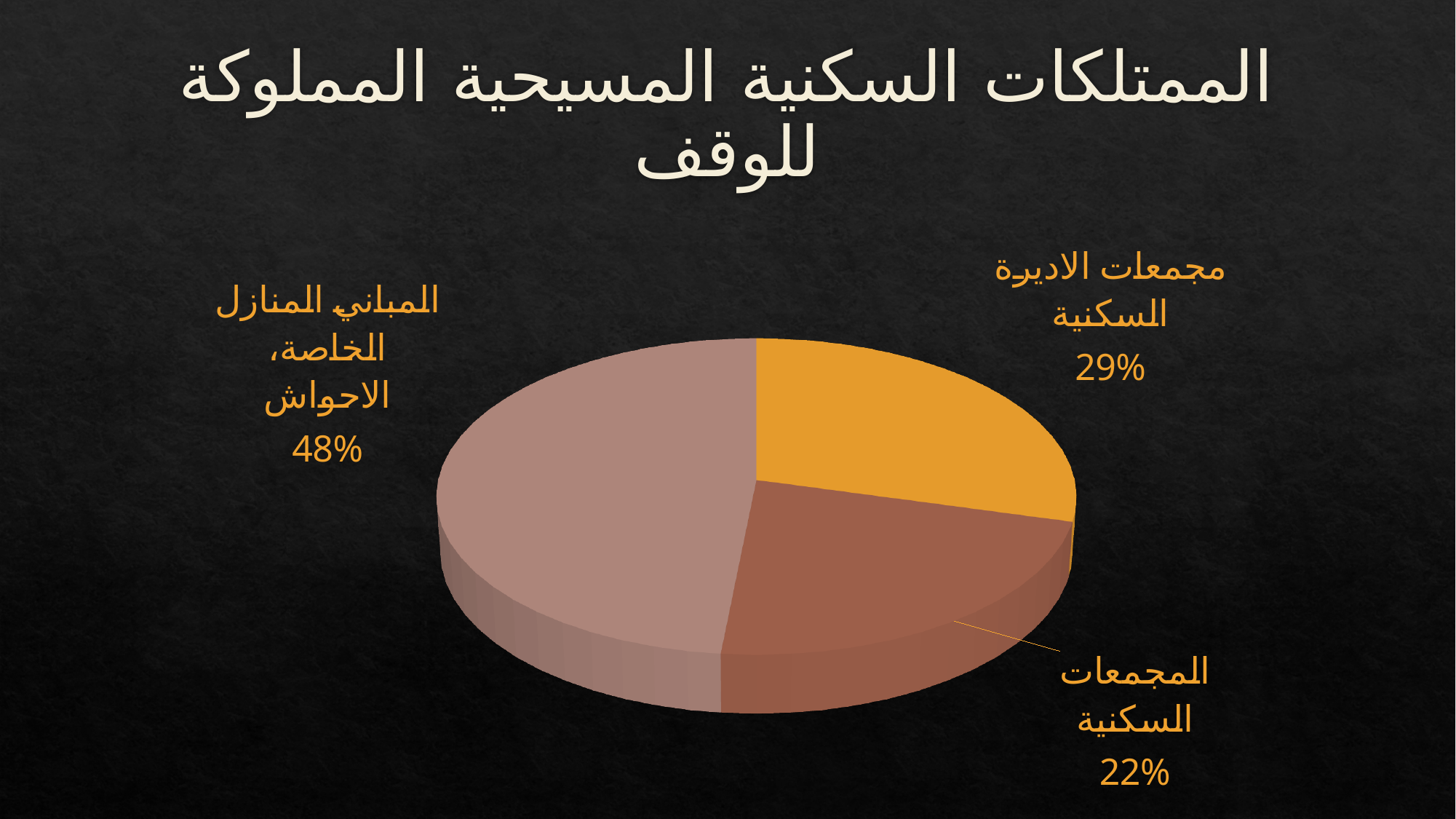
What is the difference in percentage points between المباني المنازل الخاصة، الاحواش and مجمعات الاديرة السكنية? 19 What is the title of the chart on the slide? الممتلكات السكنية المسيحية المملوكة للوقف What percentage is shown for مجمعات الاديرة السكنية? 29% What is the difference in percentage points between مجمعات الاديرة السكنية and المجمعات السكنية? 7 What kind of chart is shown on the slide? pie chart Which category has the largest share of the pie? المباني المنازل الخاصة، الاحواش What percentage is shown for المجمعات السكنية? 22% What percentage is shown for المباني المنازل الخاصة، الاحواش? 48% How many slices does the pie chart have? 3 Which category has the smallest share of the pie? المجمعات السكنية What colour is the slice for مجمعات الاديرة السكنية? orange/yellow Which is larger, the share for مجمعات الاديرة السكنية or the share for المجمعات السكنية? مجمعات الاديرة السكنية